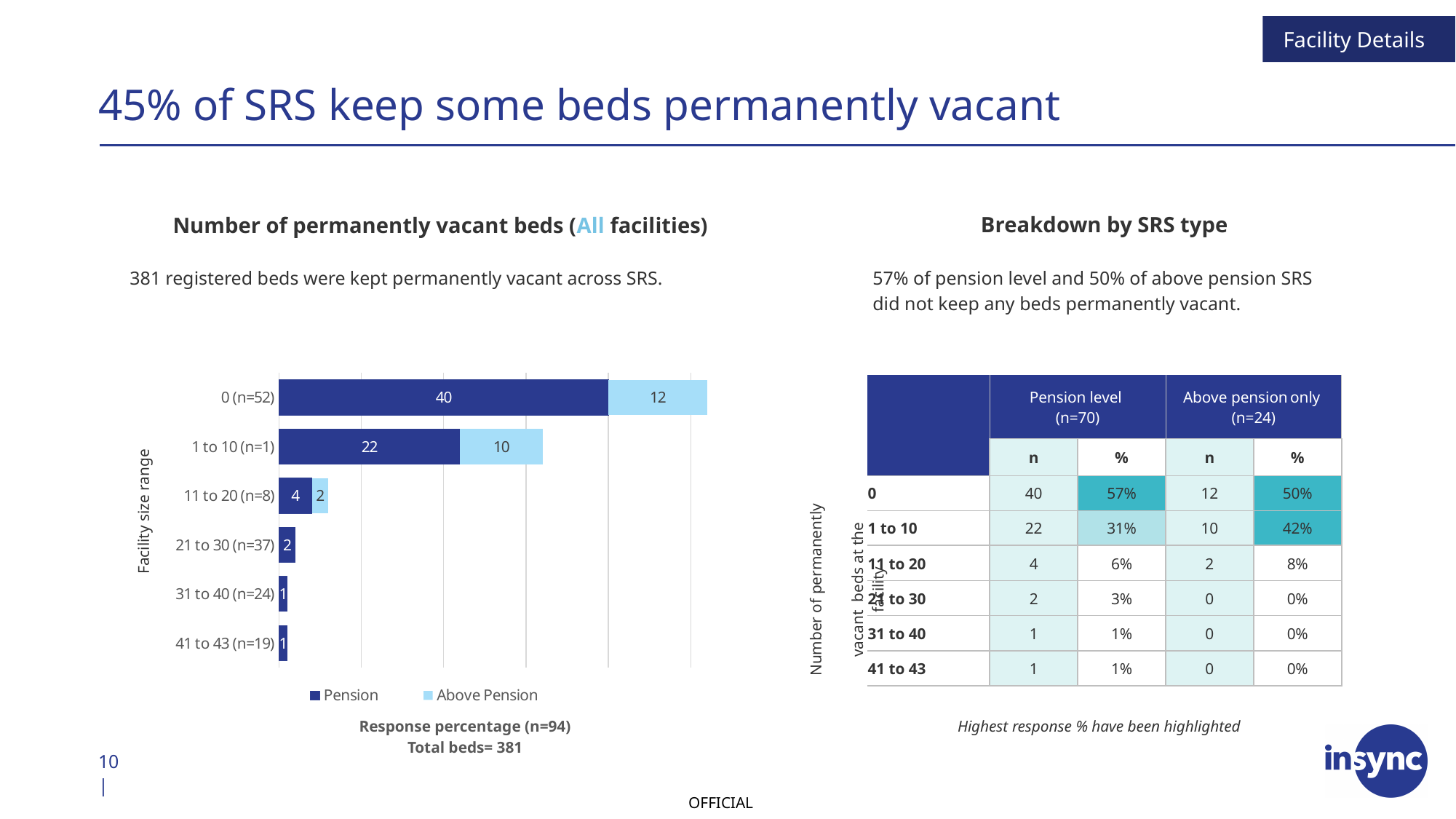
What is the Above Pension value for the '1 to 10 (n=1)' category? 10 What is the label of the y axis of the chart? Facility size range Which is larger, the Pension value for '21 to 30 (n=37)' or the Pension value for '11 to 20 (n=8)'? 11 to 20 (n=8) What is the total of the stacked bar for the '1 to 10 (n=1)' category? 32 What is the total of the stacked bar for the '11 to 20 (n=8)' category? 6 What is the difference between the Pension and Above Pension values for the '0 (n=52)' category? 28 What type of chart is shown on the slide? Stacked bar chart What is the Pension value for the '11 to 20 (n=8)' category? 4 How many facility size range categories are shown on the chart? 6 What is the Pension value for the '0 (n=52)' category? 40 How many series does the chart legend list? 2 Which category has the highest Pension value? 0 (n=52)